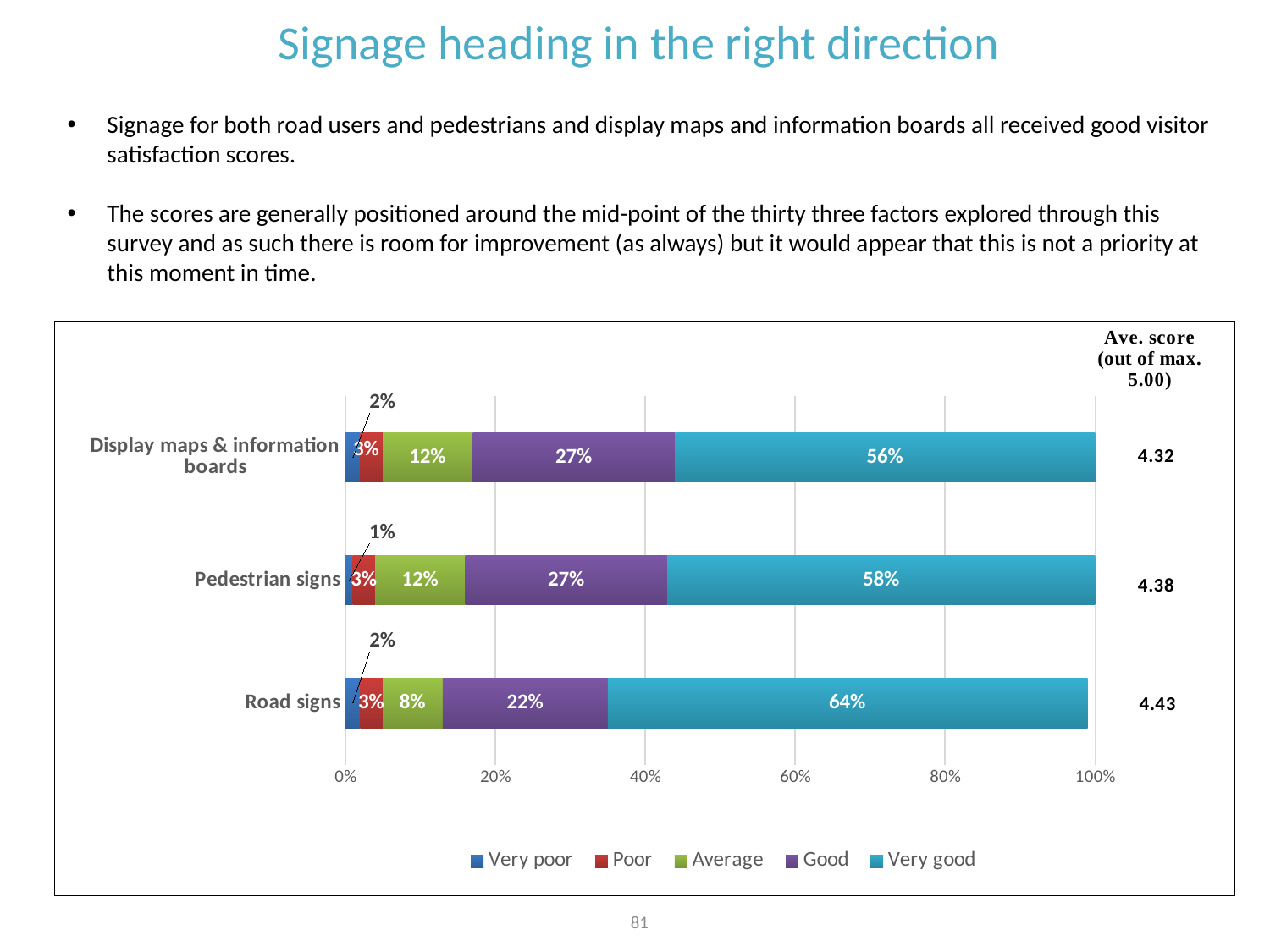
Is the 'Average' percentage larger for Pedestrian signs or Road signs? Pedestrian signs Which category has the lowest 'Very good' percentage? Display maps & information boards What is the 'Good' percentage for Pedestrian signs? 27% What is the 'Very good' percentage for Road signs? 64% Which category has the highest 'Very good' percentage? Road signs What is the difference between the 'Very good' percentages for Road signs and Pedestrian signs? 6% How many series does the chart legend list? 5 What is the 'Average' percentage for Display maps & information boards? 12% What is the 'Very poor' percentage for Pedestrian signs? 1% What kind of chart is shown on the slide? Stacked bar chart What is the average score (out of max. 5.00) shown for Road signs? 4.43 How many categories are plotted on the chart? 3